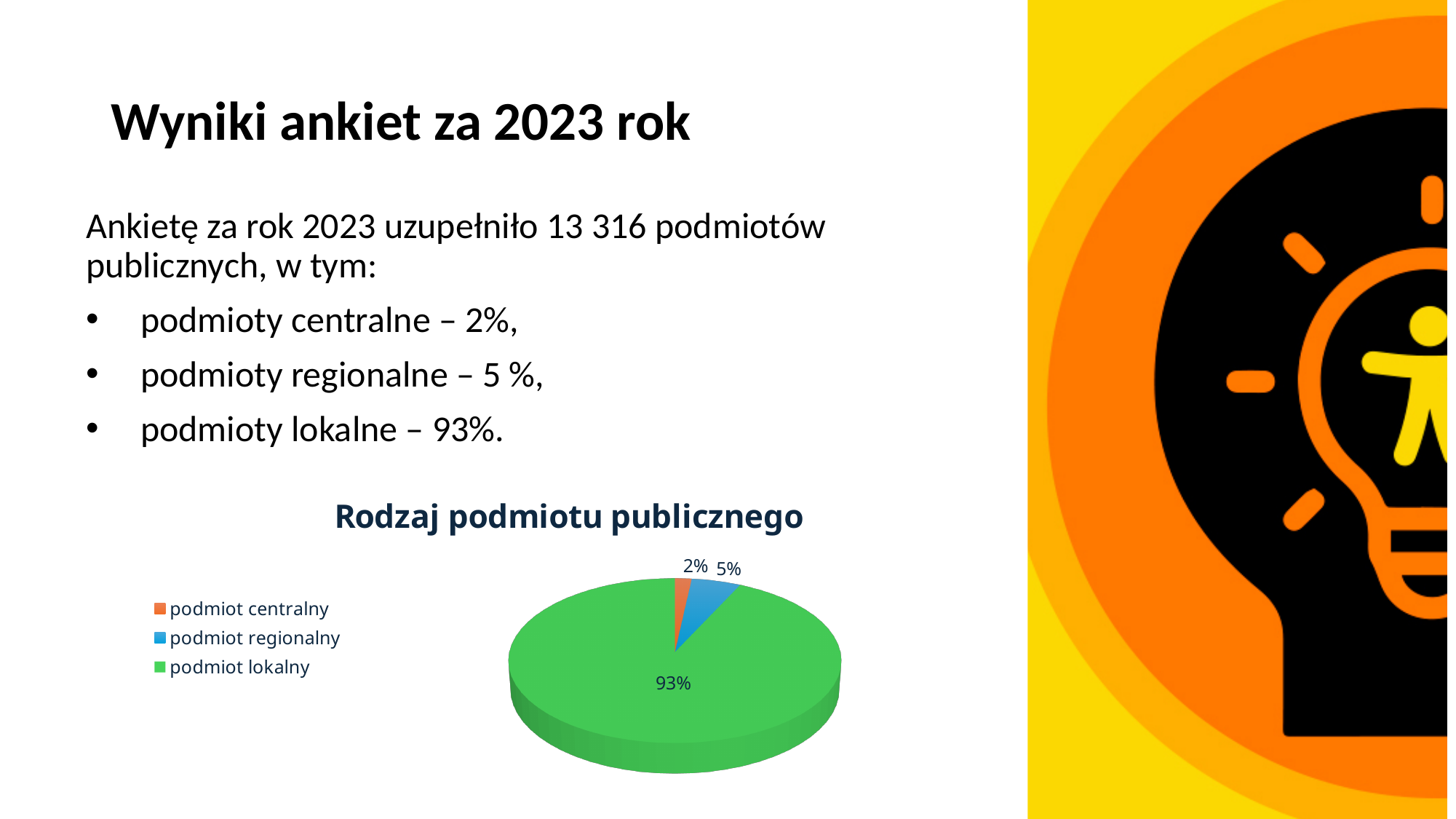
What is the title of the chart? Rodzaj podmiotu publicznego Which is larger, the slice for 'podmiot regionalny' or the slice for 'podmiot centralny'? podmiot regionalny What share of the pie does 'podmiot regionalny' have? 5% Which category has the largest slice of the pie? podmiot lokalny What is the difference in percentage points between the 'podmiot lokalny' slice and the 'podmiot regionalny' slice? 88 What colour is the 'podmiot lokalny' slice? green What share of the pie does 'podmiot lokalny' have? 93% What share of the pie does 'podmiot centralny' have? 2% Which category has the smallest slice of the pie? podmiot centralny What type of chart is shown on the slide? pie chart How many entries does the legend list? 3 How many categories does the pie chart show? 3